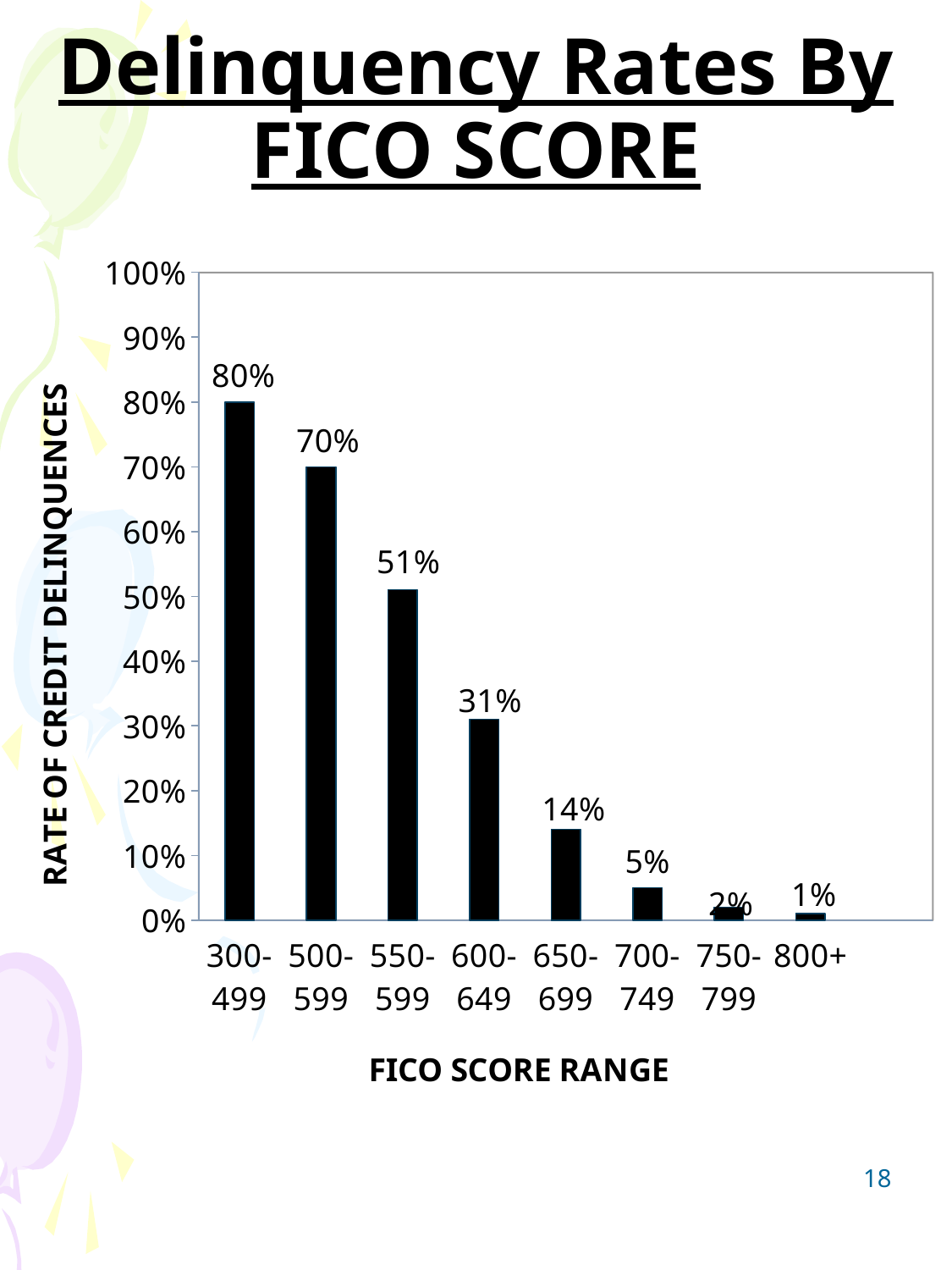
What is the delinquency rate for the 300-499 FICO score range? 80% How many FICO score ranges are shown on the x axis? 8 Do the delinquency rates rise or fall as the FICO score range increases along the x axis? fall What is the difference in delinquency rate between the 500-599 and 550-599 ranges? 19% What is the delinquency rate for the 700-749 FICO score range? 5% Which has a higher delinquency rate, the 650-699 range or the 600-649 range? 600-649 Is the delinquency rate for the 550-599 range greater or less than 50%? greater What is the label of the y axis? RATE OF CREDIT DELINQUENCES Which FICO score range has the highest delinquency rate? 300-499 Which FICO score range has the lowest delinquency rate? 800+ What kind of chart is shown on the slide? bar chart What is the delinquency rate for the 600-649 FICO score range? 31%